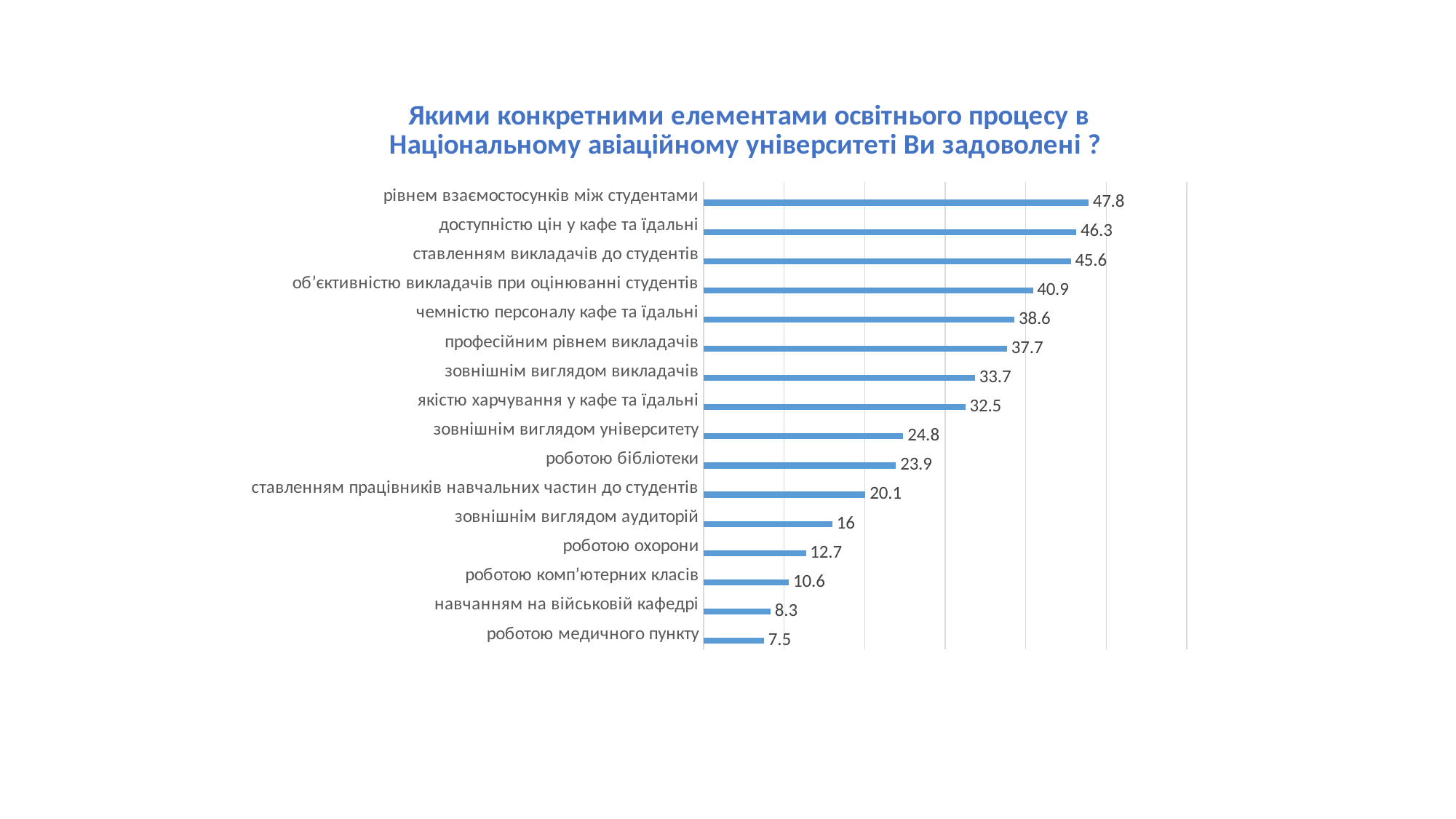
Which has a larger value: "роботою охорони" or "роботою комп'ютерних класів"? роботою охорони What value is shown for "рівнем взаємостосунків між студентами"? 47.8 What value is shown for "роботою бібліотеки"? 23.9 What kind of chart is shown on the slide? Bar chart What is the difference between the values for "об’єктивністю викладачів при оцінюванні студентів" and "чемністю персоналу кафе та їдальні"? 2.3 What value is shown for "зовнішнім виглядом аудиторій"? 16 What is the difference between the highest value (47.8) and the lowest value (7.5)? 40.3 How many categories are shown in the chart? 16 What value is shown for "навчанням на військовій кафедрі"? 8.3 Which category has the lowest value? роботою медичного пункту Do the values increase or decrease going from the top bar to the bottom bar? Decrease Which category has the highest value? рівнем взаємостосунків між студентами